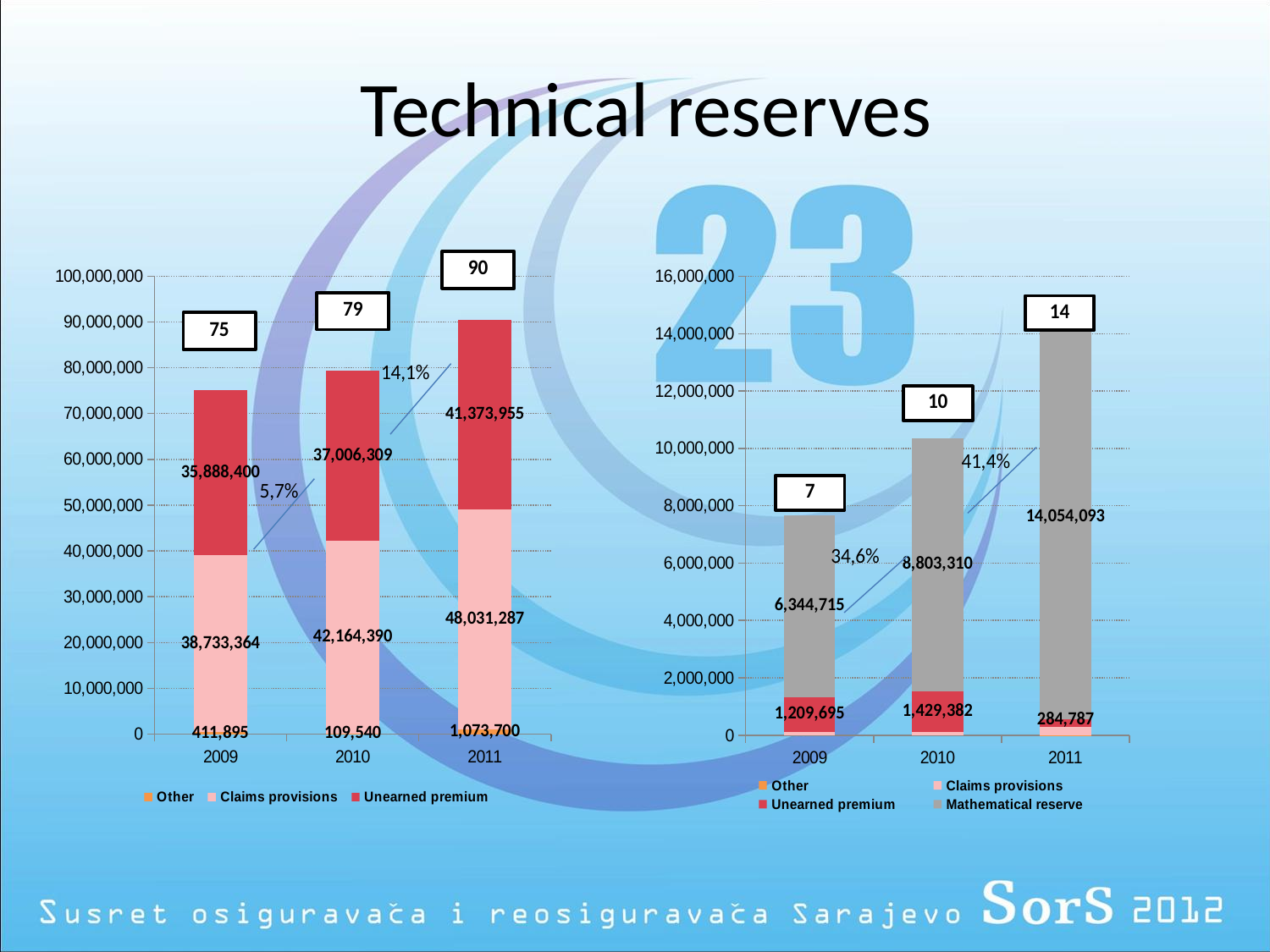
On the left chart, by how much did Claims provisions increase from 2010 to 2011? 5,866,897 On the left chart, what is the value of Claims provisions for 2011? 48,031,287 On the left chart, what is the value of Unearned premium for 2009? 35,888,400 On the right chart, which year has the highest Mathematical reserve? 2011 On the left chart, what is the value of Other for 2010? 109,540 What kind of chart is the left chart? Stacked bar chart On the right chart, what is the value of Unearned premium for 2010? 1,429,382 How many series does the legend of the right chart list? 4 On the right chart, what is the difference between the Mathematical reserve in 2010 and in 2009? 2,458,595 On the right chart, what is the value of Mathematical reserve for 2011? 14,054,093 On the left chart, which is larger in 2010: Claims provisions or Unearned premium? Claims provisions How many series does the legend of the left chart list? 3